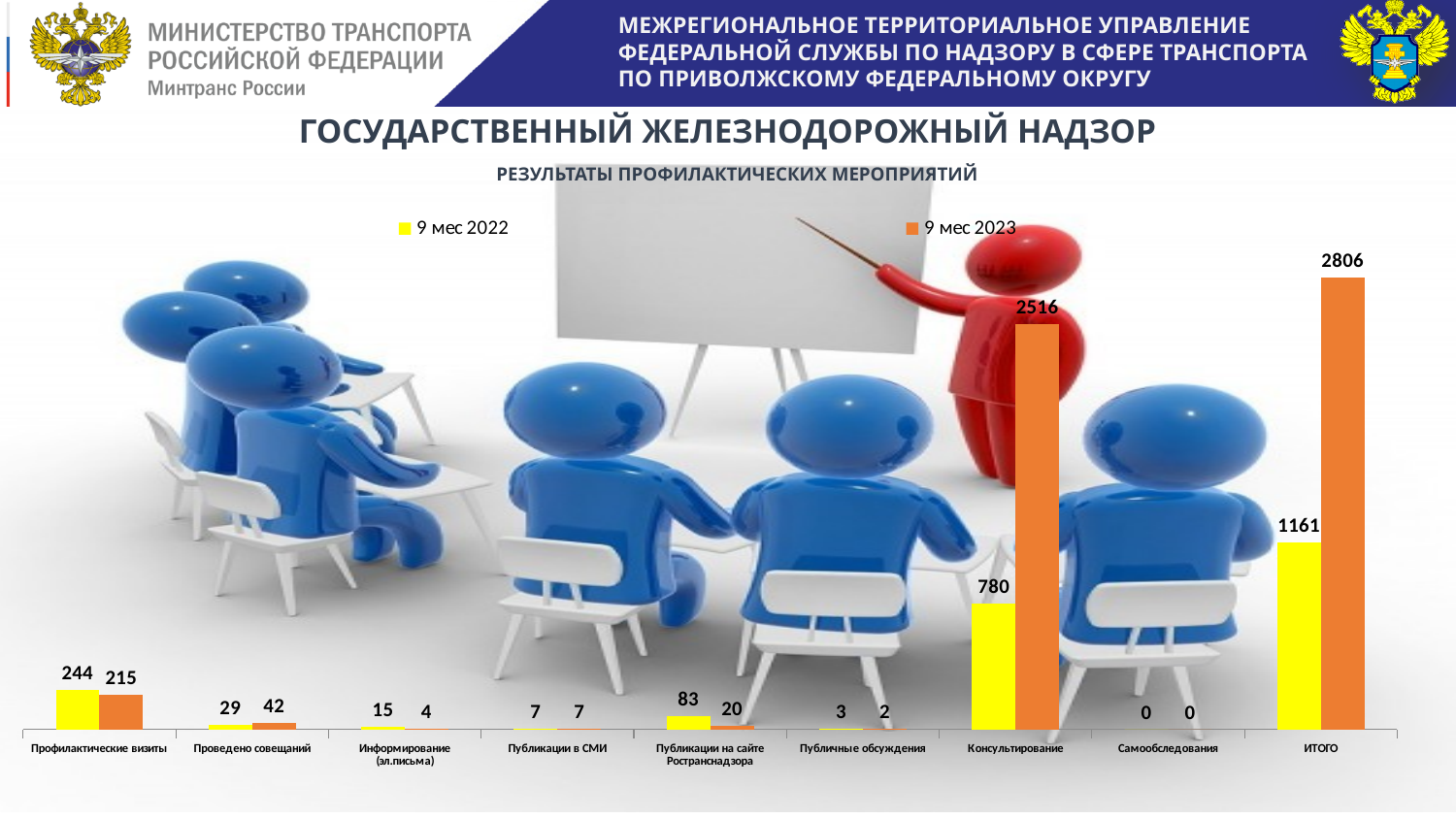
What is the value for Самообследования in the 9 мес 2023 series? 0 How many categories are shown on the x axis of the chart? 9 What is the value for Консультирование in the 9 мес 2023 series? 2516 What is the difference between the ИТОГО values for 9 мес 2023 and 9 мес 2022? 1645 How many series does the chart legend list? 2 What is the value for Консультирование in the 9 мес 2022 series? 780 What is the ИТОГО value for 9 мес 2023? 2806 What is the value for Публикации на сайте Ространснадзора in the 9 мес 2022 series? 83 What is the difference between the 9 мес 2023 and 9 мес 2022 values for Консультирование? 1736 Which category has the highest value in the 9 мес 2022 series, excluding ИТОГО? Консультирование Which is larger for Профилактические визиты: the 9 мес 2022 value or the 9 мес 2023 value? 9 мес 2022 What kind of chart is shown on the slide? bar chart